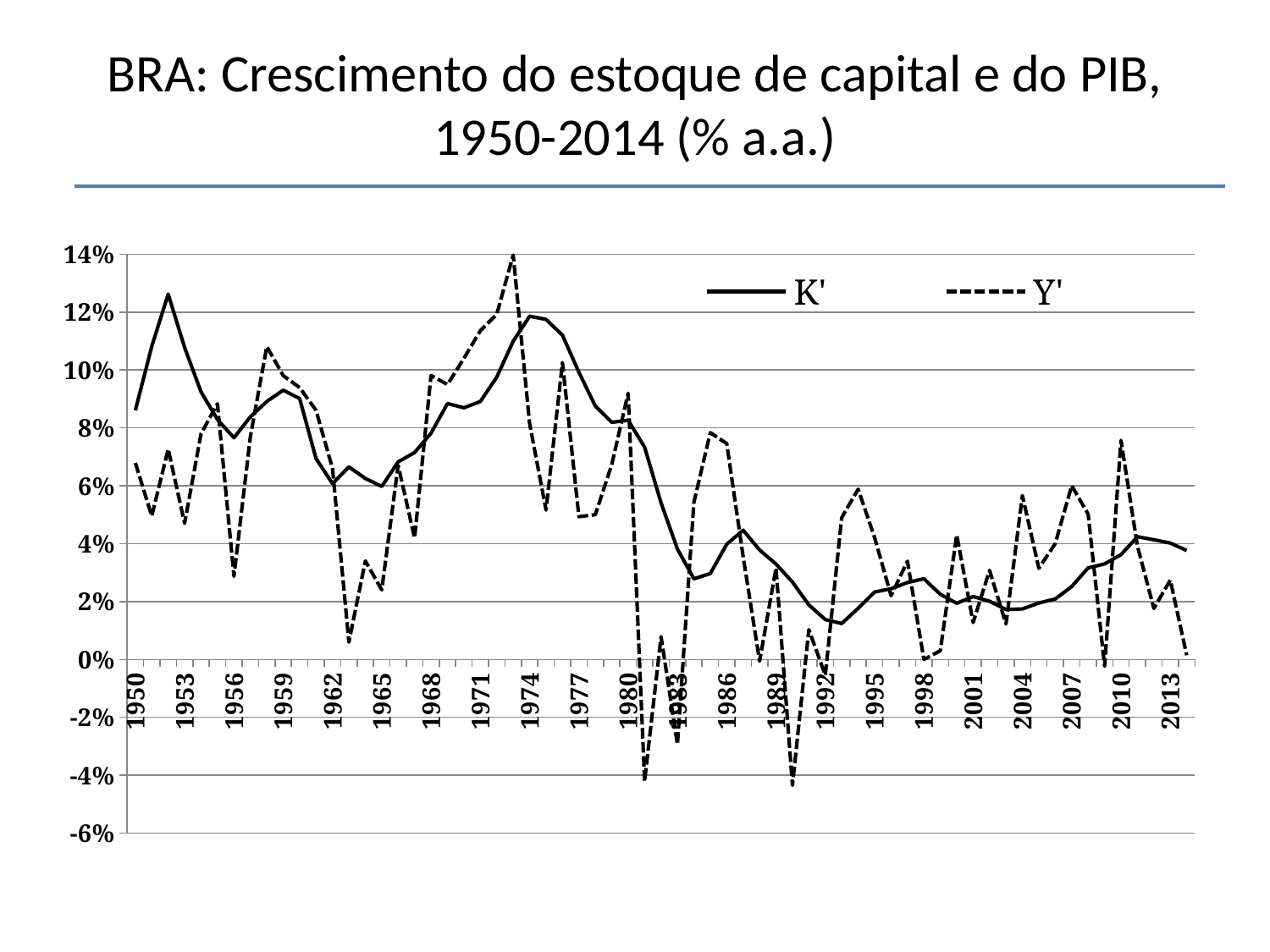
In 1952, which series has the larger value, K' or Y'? K' Is the value of Y' in 1981 greater or less than -2%? less Is the value of K' in 1952 greater or less than 12%? greater In 1973, which series has the larger value, K' or Y'? Y' What is the title of the chart? BRA: Crescimento do estoque de capital e do PIB, 1950-2014 (% a.a.) Is the value of K' in 1993 greater or less than 2%? less How many series does the legend list? 2 What kind of chart is shown on the slide? line chart Which series is drawn with a dashed line? Y' Does the K' series rise or fall between 1974 and 1993? fall